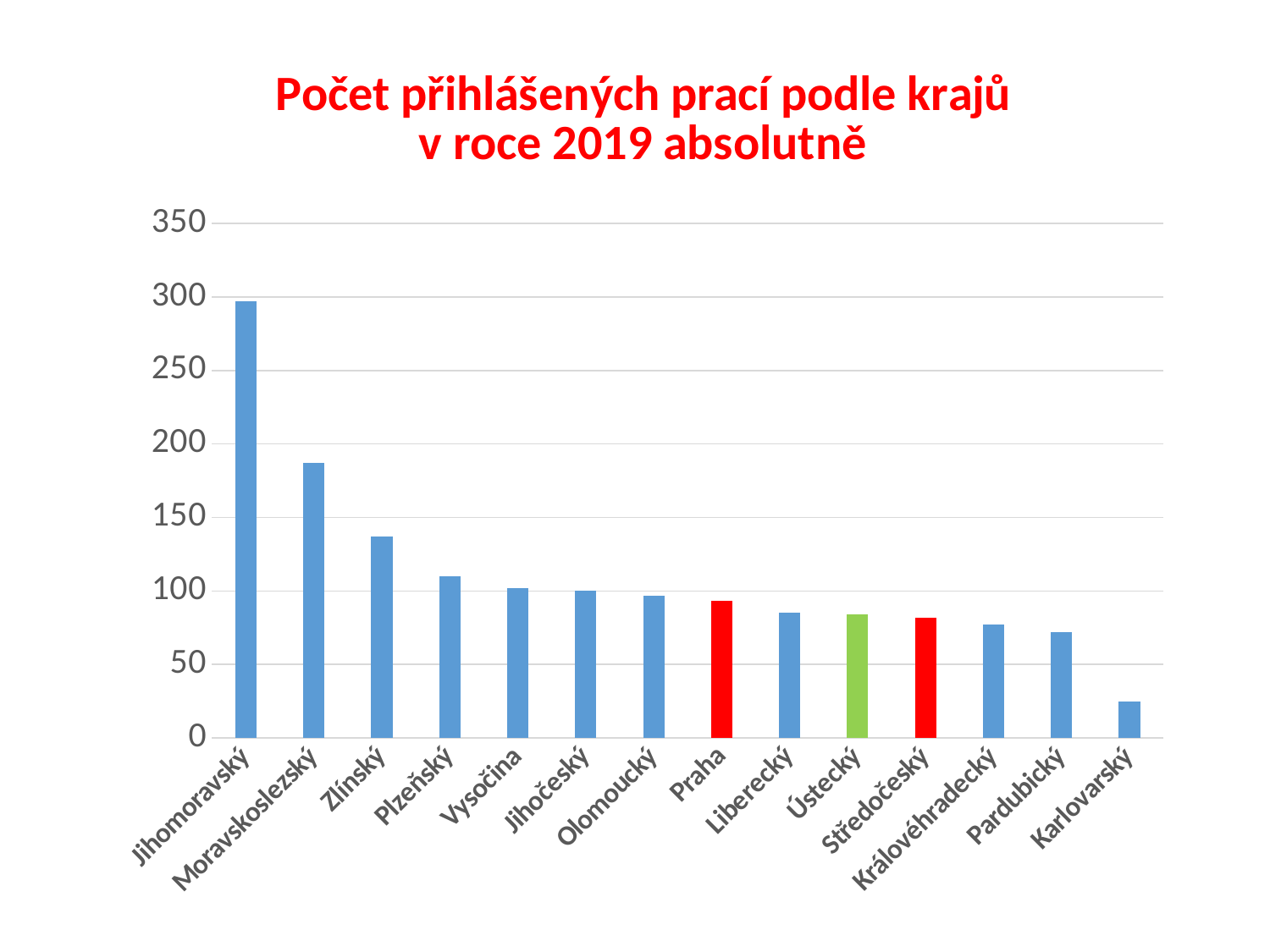
Do the values rise or fall from left to right along the x axis? fall Is the value for Moravskoslezský greater or less than 200? less Which has the larger value, Praha or Karlovarský? Praha Is the value for Karlovarský greater or less than 50? less How many regions (categories) are shown on the x axis? 14 What kind of chart is shown on the slide? bar chart Which region has the highest number of submitted works? Jihomoravský Which region has the lowest number of submitted works? Karlovarský Is the value for Jihomoravský greater or less than 250? greater Which has the larger value, Zlínský or Plzeňský? Zlínský Which region's bar is coloured green? Ústecký